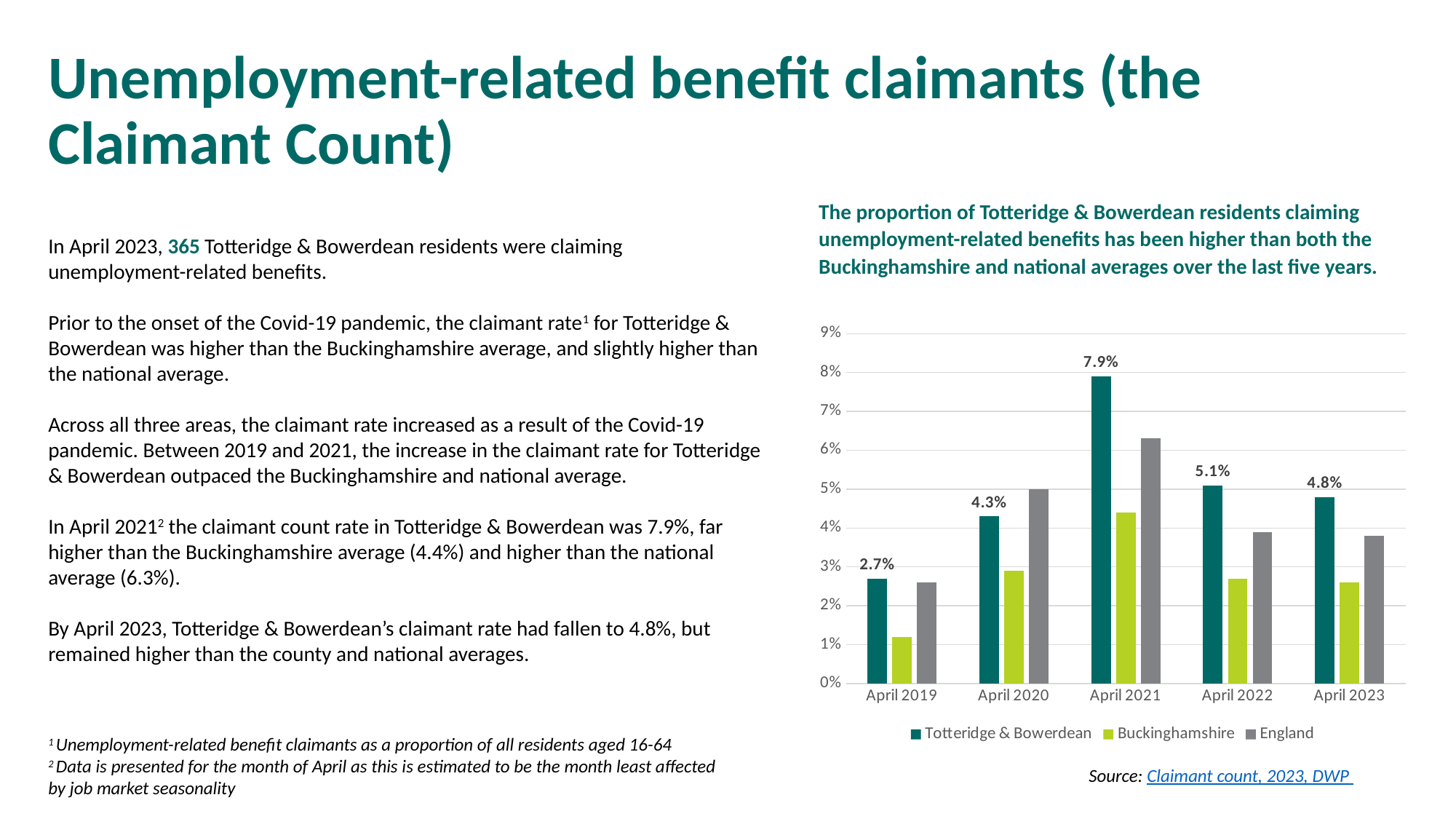
Is the value for England in April 2021 greater or less than 5%? greater Is the value for Buckinghamshire in April 2019 greater or less than 2%? less Which is larger for Totteridge & Bowerdean: the April 2020 rate or the April 2022 rate? April 2022 What is the claimant rate for Totteridge & Bowerdean in April 2021? 7.9% In which year is the Totteridge & Bowerdean claimant rate lowest? April 2019 Does the Totteridge & Bowerdean claimant rate rise or fall from April 2021 to April 2023? Fall How many series does the chart's legend list? 3 In which year is the Totteridge & Bowerdean claimant rate highest? April 2021 What is the claimant rate for Totteridge & Bowerdean in April 2019? 2.7% How many years are shown on the x axis of the chart? 5 By how many percentage points did the Totteridge & Bowerdean claimant rate fall between April 2021 and April 2023? 3.1 percentage points What kind of chart is shown on the slide? Bar chart